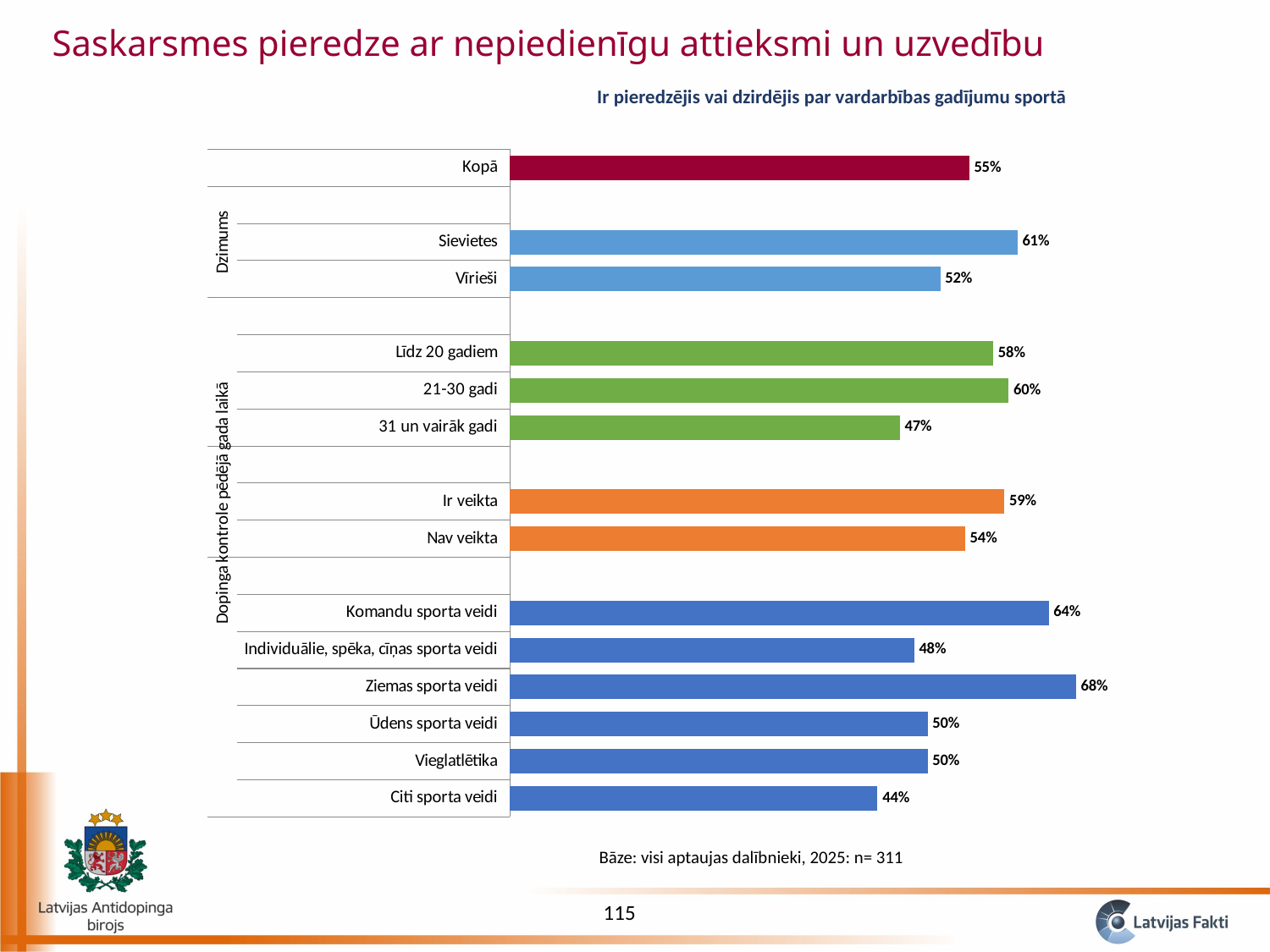
What is the value for Kopā? 55% What is the difference between the values for Sievietes and Vīrieši? 9% What is the value for Ziemas sporta veidi? 68% What is the value for 31 un vairāk gadi? 47% Which category has the highest value? Ziemas sporta veidi What is the difference between the values for Komandu sporta veidi and Individuālie, spēka, cīņas sporta veidi? 16% What kind of chart is shown on the slide? Bar chart What is the value for Sievietes? 61% Which is larger, the value for Ir veikta or the value for Nav veikta? Ir veikta How many bars are plotted in the chart? 14 Which category has the lowest value? Citi sporta veidi What is the title shown above the chart? Ir pieredzējis vai dzirdējis par vardarbības gadījumu sportā